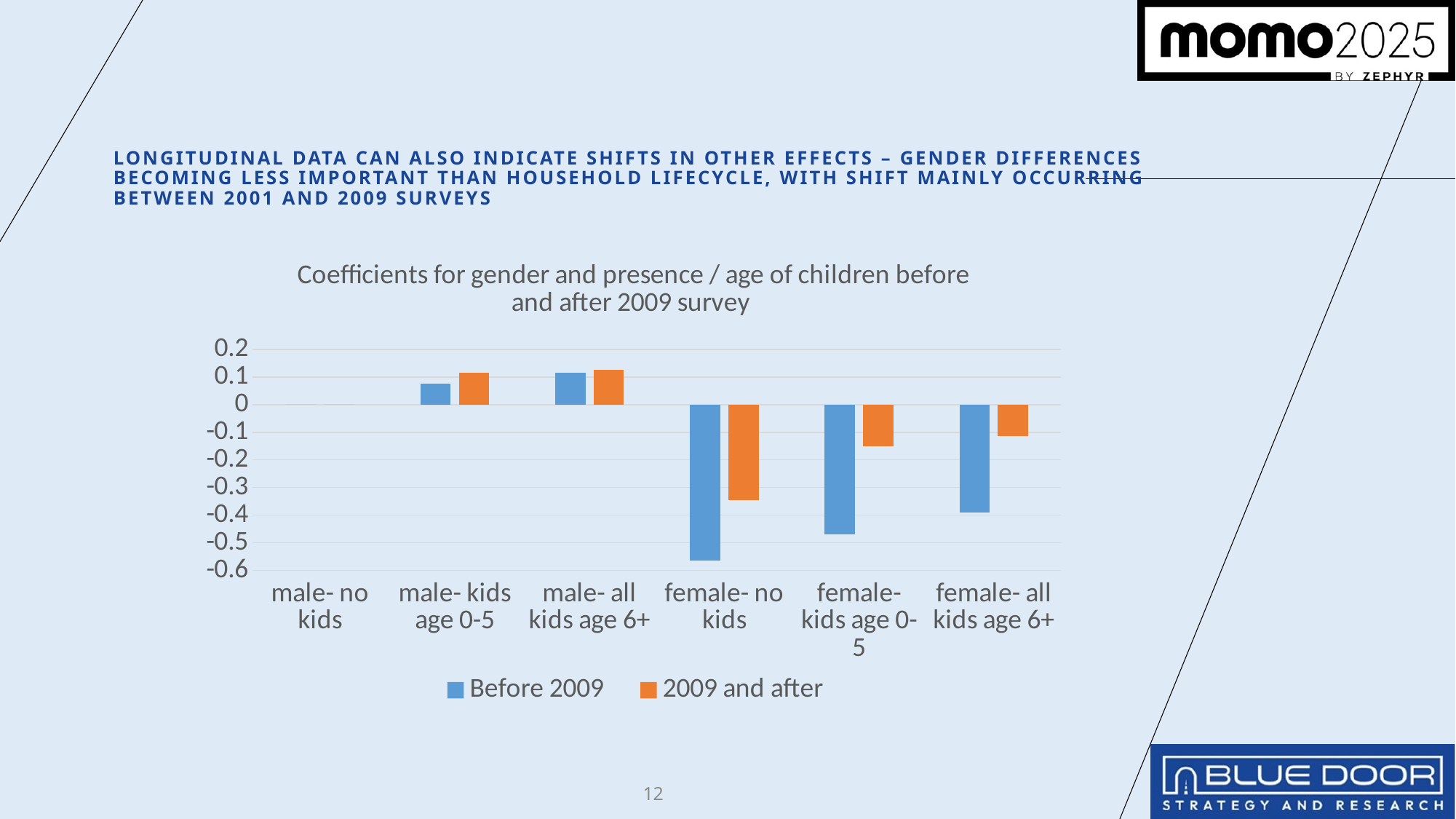
How many categories are shown on the x axis of the chart? 6 Which category has the lowest value for the 2009 and after series? female- no kids Is the Before 2009 value for female- kids age 0-5 greater or less than -0.4? less How many series does the chart's legend list? 2 What is the title of the chart? Coefficients for gender and presence / age of children before and after 2009 survey Is the 2009 and after value for female- kids age 0-5 greater or less than -0.2? greater For female- all kids age 6+, which series has the higher value, Before 2009 or 2009 and after? 2009 and after Which category has the highest value for the Before 2009 series? male- all kids age 6+ Is the 2009 and after value for female- no kids greater or less than -0.4? greater What kind of chart is shown on the slide? bar chart Which category has the lowest value for the Before 2009 series? female- no kids